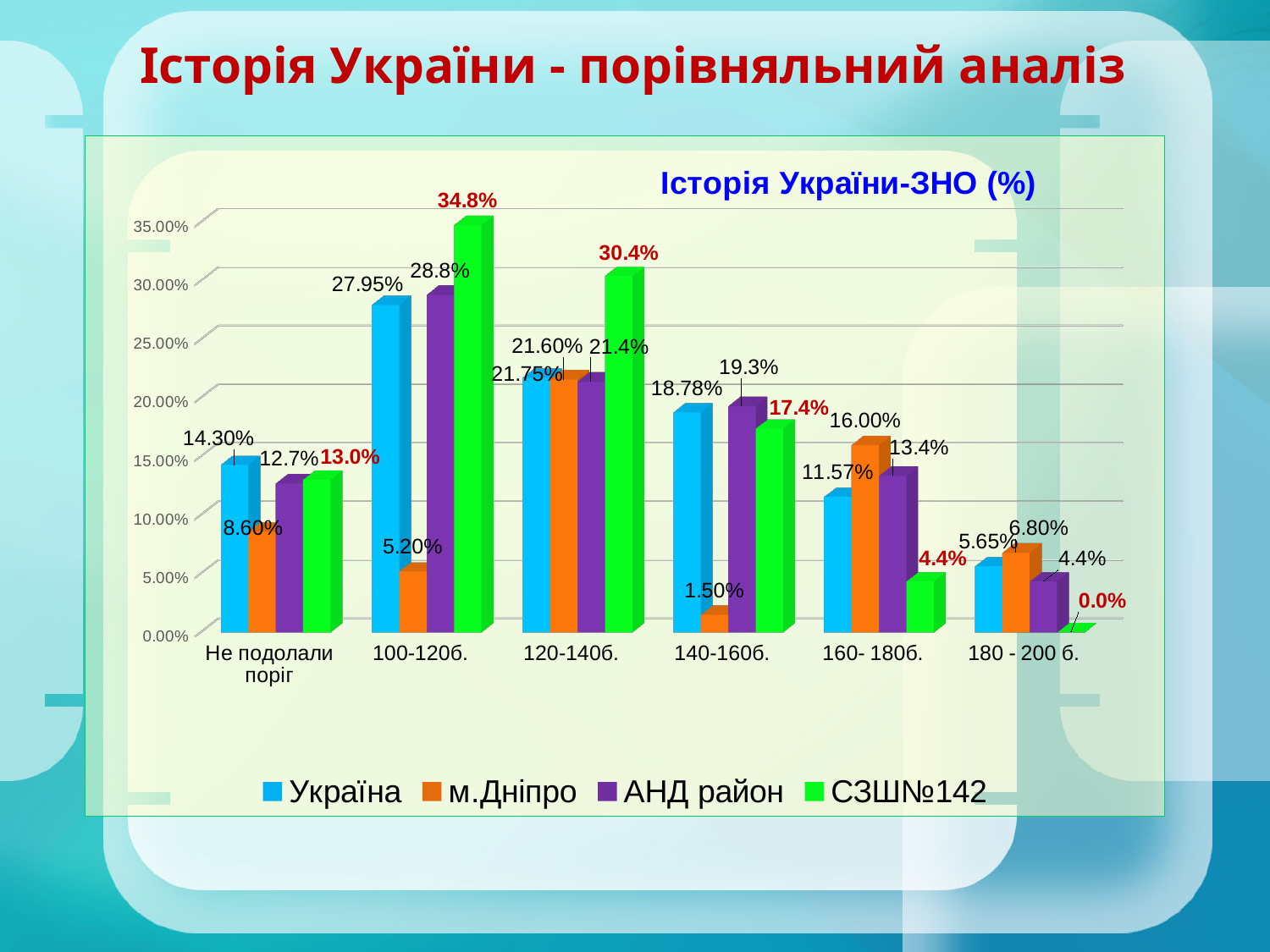
What is the title of the chart? Історія України-ЗНО (%) In the 160-180б. category, which is larger: м.Дніпро or СЗШ№142? м.Дніпро What is the value for СЗШ№142 in the 100-120б. category? 34.8% What is the value for м.Дніпро in the 140-160б. category? 1.50% What is the difference between the СЗШ№142 value and the Україна value in the 120-140б. category? 8.65% What is the value for АНД район in the 160-180б. category? 13.4% How many categories are shown on the x axis? 6 What kind of chart is shown on the slide? Bar chart Which category has the highest value for СЗШ№142? 100-120б. Which category has the lowest value for м.Дніпро? 140-160б. How many series does the legend list? 4 What is the value for Україна in the 'Не подолали поріг' category? 14.30%